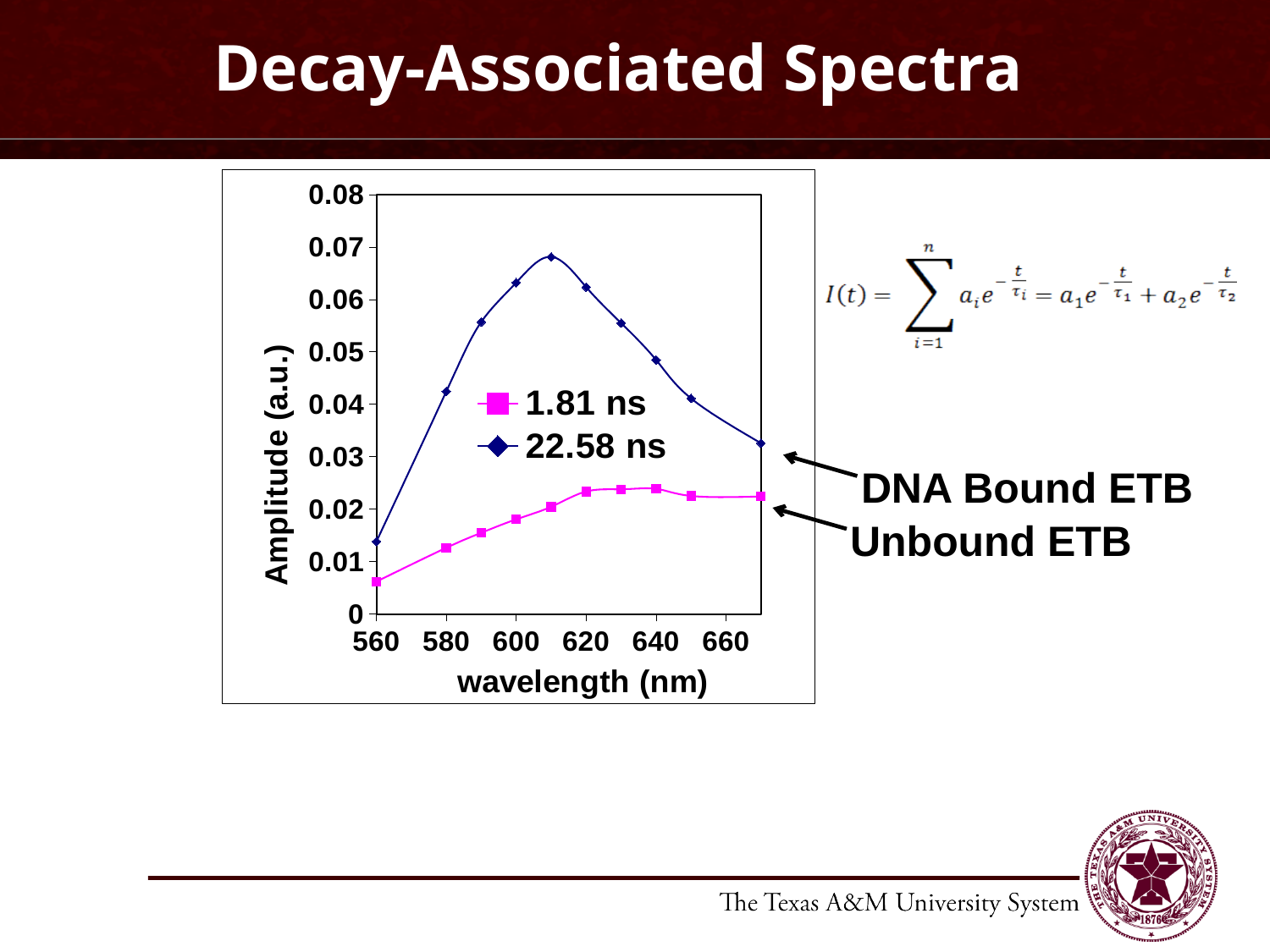
Does the amplitude of the 22.58 ns series rise or fall from 610 nm to 670 nm? fall Does the amplitude of the 1.81 ns series rise or fall from 560 nm to 640 nm? rise At which wavelength does the 22.58 ns series reach its peak amplitude? 610 How many series does the legend list? 2 Is the amplitude of the 1.81 ns series at 560 nm greater or less than 0.01? less Is the amplitude of the 22.58 ns series at 610 nm greater or less than 0.06? greater Which series reaches the highest amplitude on the chart? 22.58 ns Is the amplitude of the 22.58 ns series at 630 nm greater or less than 0.05? greater What is the label of the x axis? wavelength (nm) At 610 nm, which series has the larger amplitude, 1.81 ns or 22.58 ns? 22.58 ns What kind of chart is shown on the slide? line chart What are the two series named in the legend? 1.81 ns and 22.58 ns